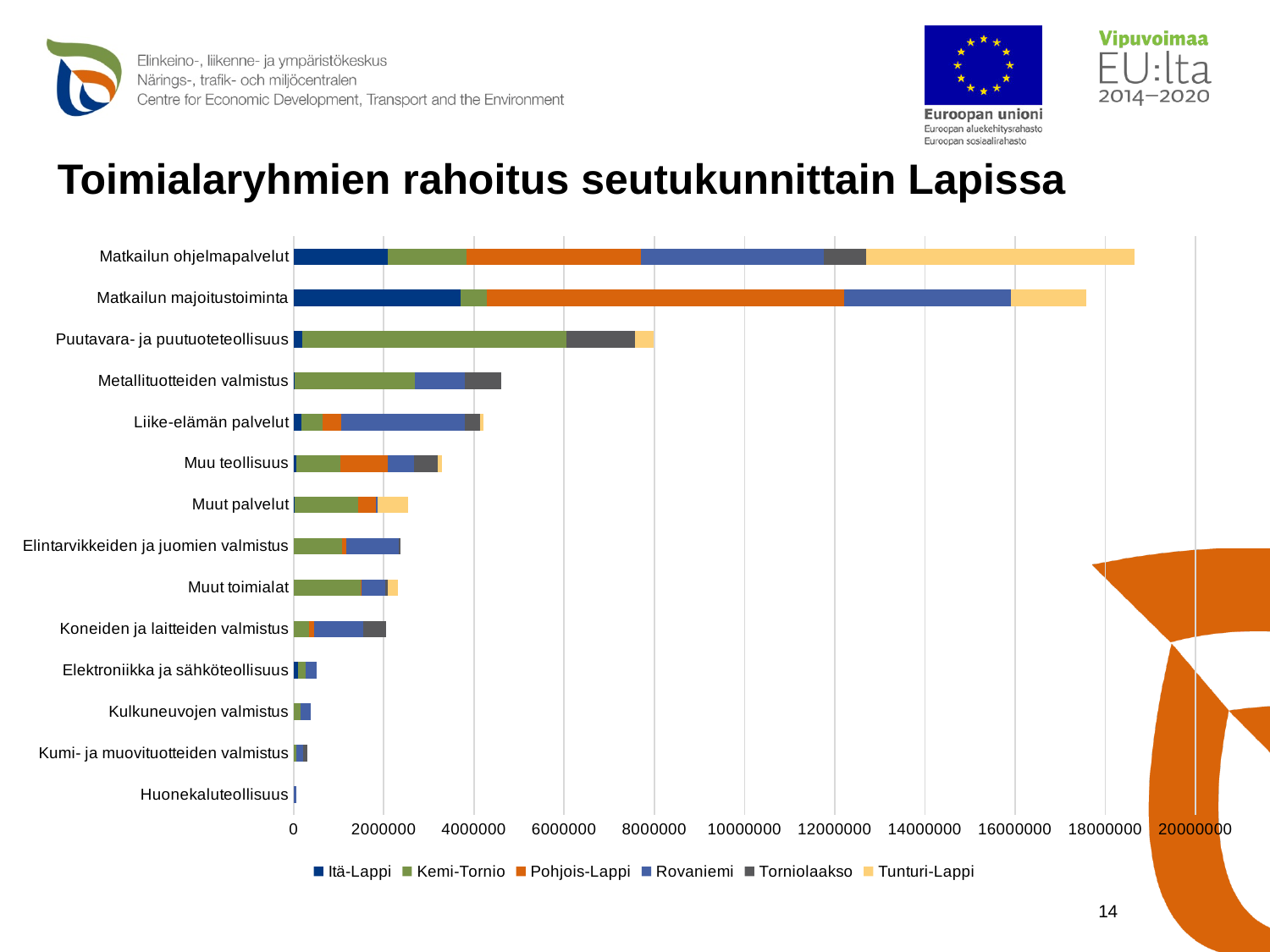
How many industry categories are plotted on the chart? 14 What kind of chart is shown on the slide? Stacked bar chart Is the total bar for Metallituotteiden valmistus greater or less than 4000000? greater Which category has the longest total bar? Matkailun ohjelmapalvelut How many series does the legend list? 6 Which has the longer total bar, Puutavara- ja puutuoteteollisuus or Metallituotteiden valmistus? Puutavara- ja puutuoteteollisuus Is the total bar for Elektroniikka ja sähköteollisuus greater or less than 2000000? less Is the total bar for Matkailun majoitustoiminta greater or less than 18000000? less What is the title of the chart? Toimialaryhmien rahoitus seutukunnittain Lapissa Which series is shown in orange in the legend? Pohjois-Lappi Which category has the shortest total bar? Huonekaluteollisuus